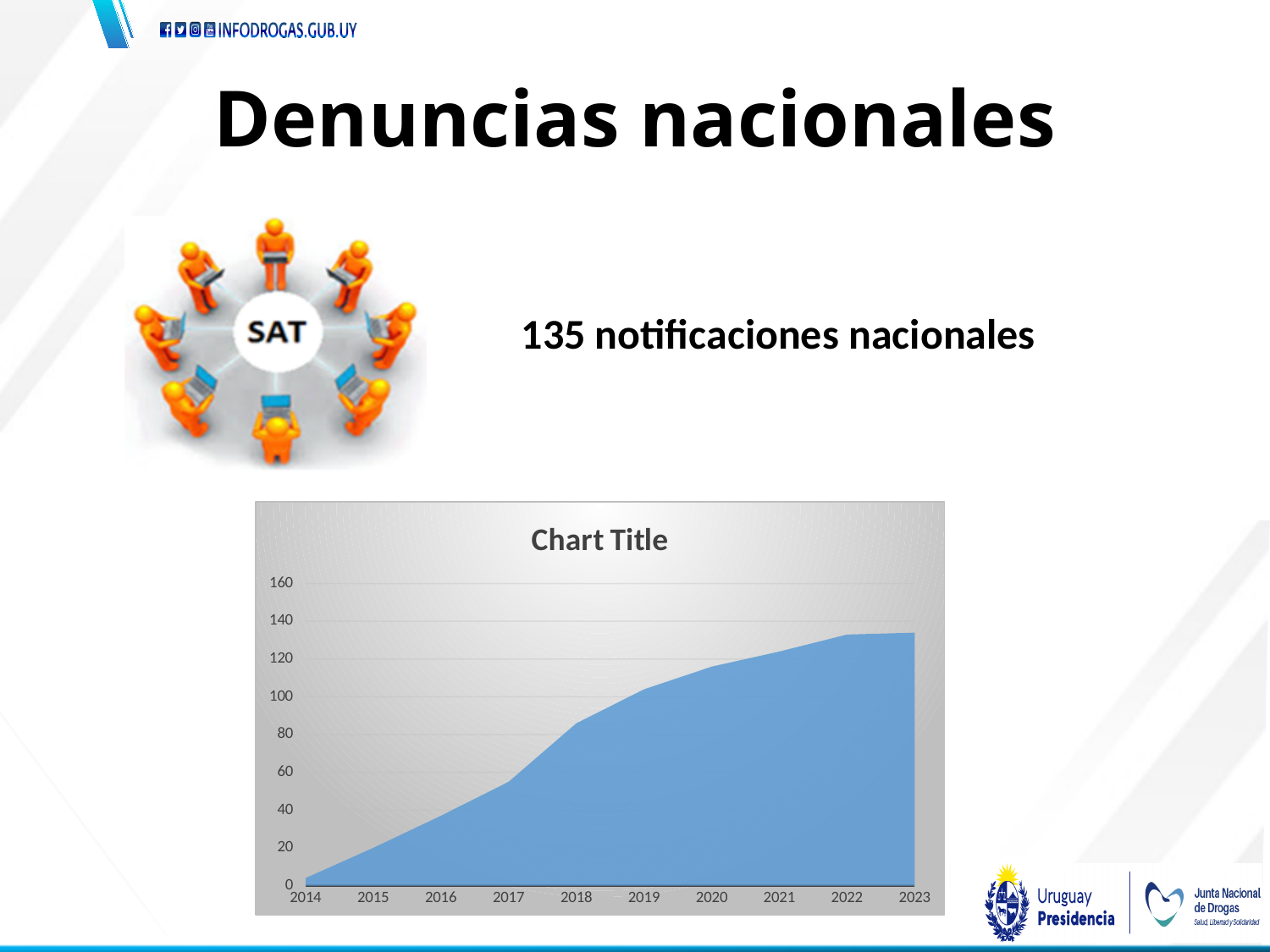
Is the value for 2017 greater or less than 60? less Is the value for 2022 greater or less than 120? greater What is the title shown on the chart? Chart Title Do the values in the chart rise or fall from 2014 to 2023? rise Which year has the lowest value in the chart? 2014 Is the value for 2023 greater or less than 140? less Which is larger, the value for 2016 or the value for 2019? 2019 How many years are plotted along the x axis of the chart? 10 What kind of chart is shown on the slide? area chart